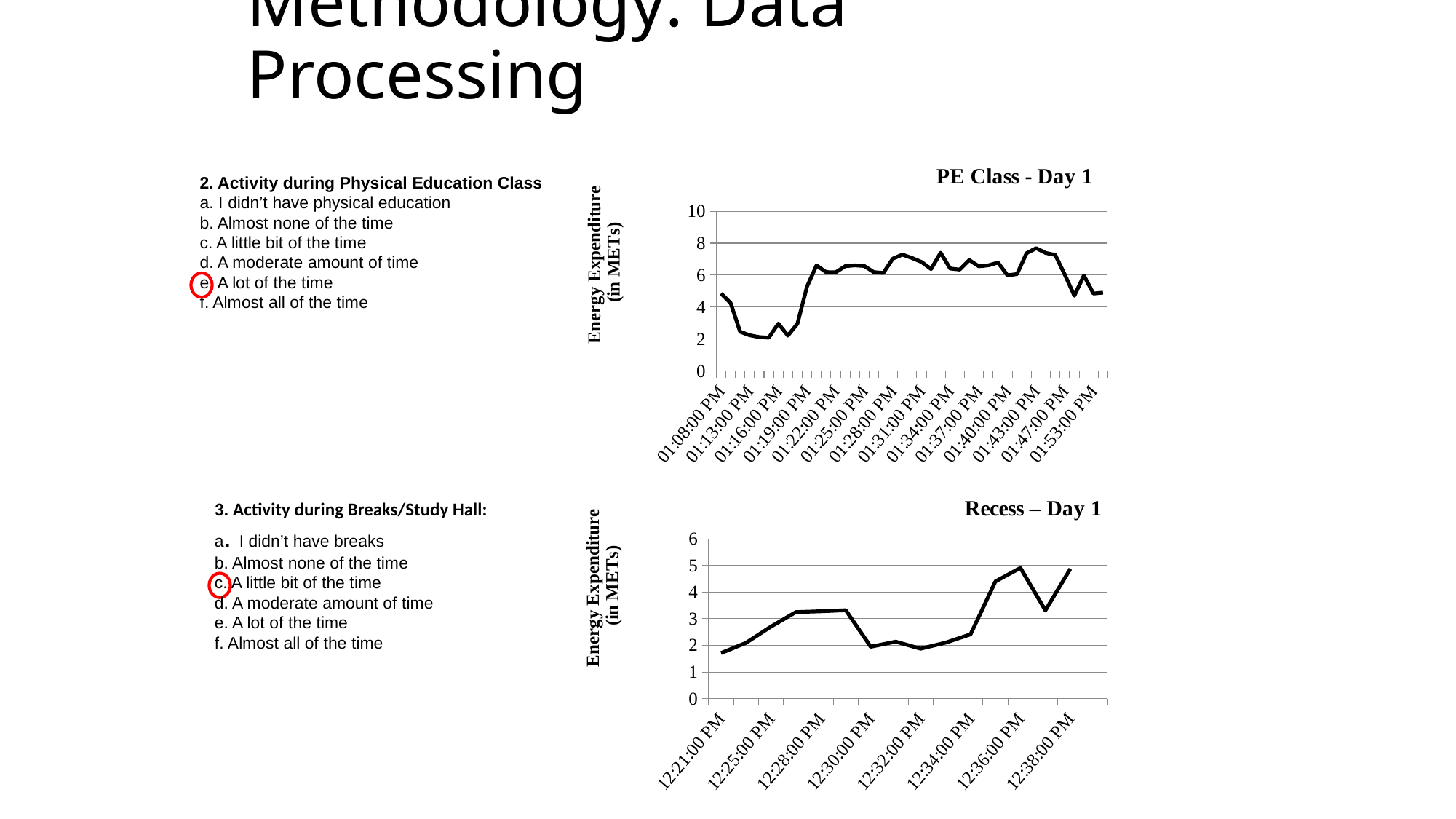
In the "PE Class - Day 1" chart, is the value at 01:16:00 PM greater or less than 4? less What kind of chart is the "Recess – Day 1" chart? line chart In the "PE Class - Day 1" chart, is the highest value on the line greater or less than 7? greater What is the title of the lower chart on the slide? Recess – Day 1 In the "Recess – Day 1" chart, is the value at 12:21:00 PM greater or less than 2? less What is the y-axis label on the "PE Class - Day 1" chart? Energy Expenditure (in METs) In the "Recess – Day 1" chart, does the line rise or fall between 12:21:00 PM and 12:28:00 PM? rise How many time labels are shown on the x axis of the "Recess – Day 1" chart? 8 What kind of chart is the "PE Class - Day 1" chart? line chart